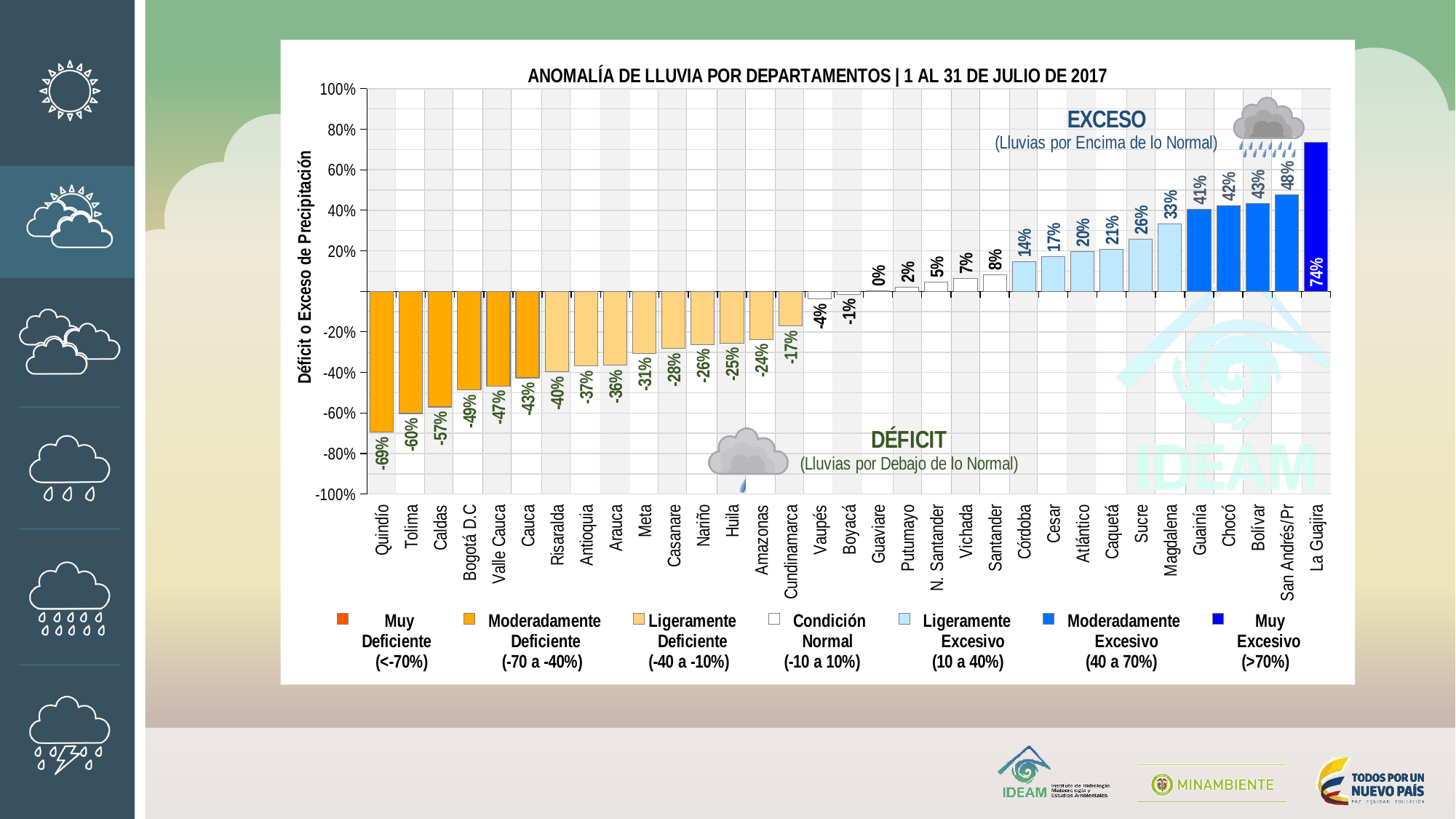
Which has a larger rainfall anomaly value, Sucre or Córdoba? Sucre How many categories does the legend list? 7 What is the rainfall anomaly value shown for Quindío? -69% Which department has the highest rainfall anomaly value on the chart? La Guajira What is the rainfall anomaly value shown for Cundinamarca? -17% What is the rainfall anomaly value shown for Magdalena? 33% Which department has the lowest rainfall anomaly value on the chart? Quindío How many departments are shown on the x axis of the chart? 33 What is the rainfall anomaly value shown for La Guajira? 74% Is the value for Tolima greater or less than -40%? less What is the difference between the values for San Andrés/Pr and Guainía? 7% What kind of chart is shown on the slide? Bar chart